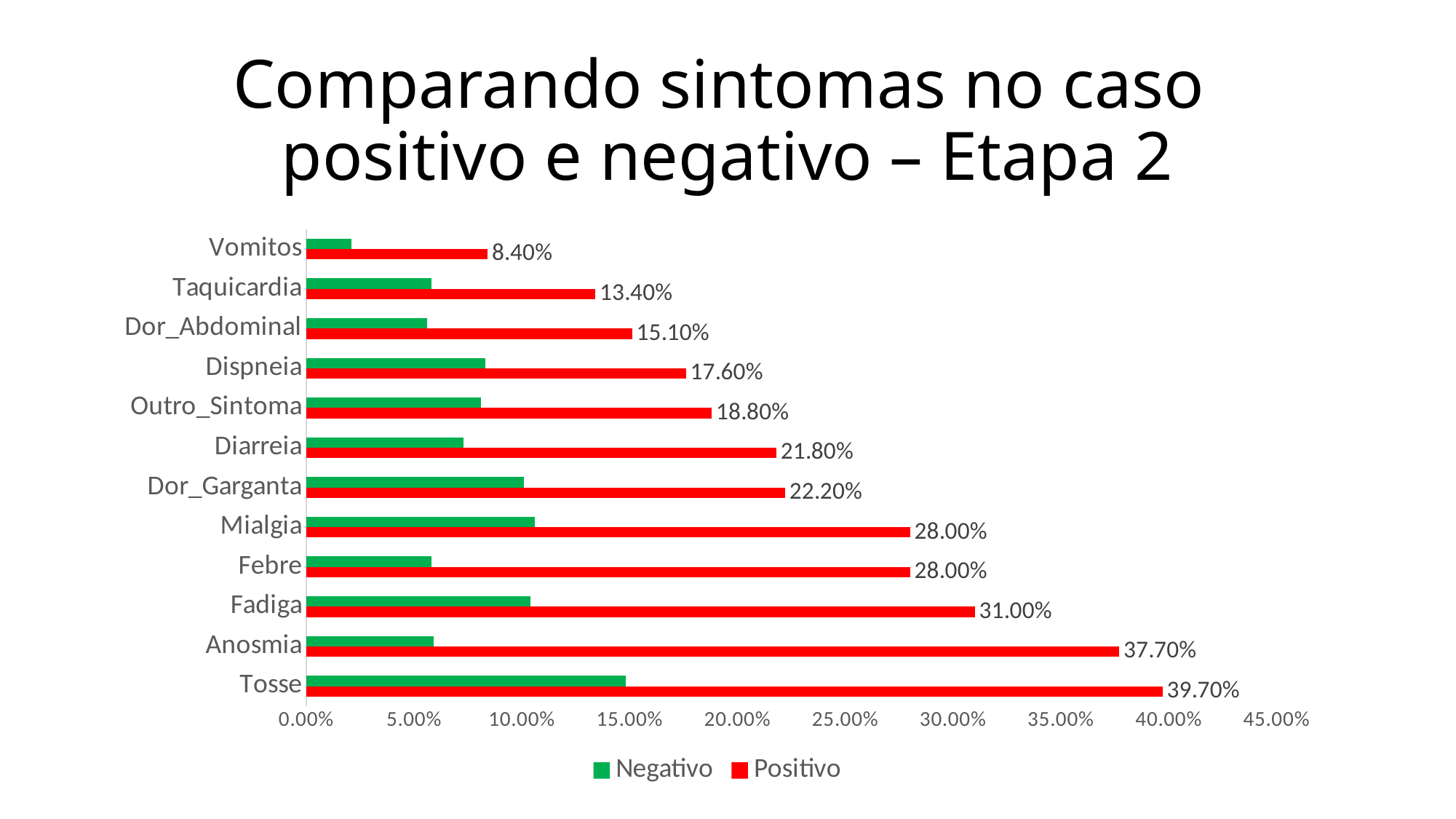
What is the Positivo value for Anosmia? 37.70% How many series does the legend list? 2 Is the Negativo value for Tosse greater or less than 10.00%? greater How many symptoms are listed on the chart? 12 What is the difference between the Positivo values for Tosse and Anosmia? 2.00% Which symptom has the highest Positivo value? Tosse Which symptom has the lowest Positivo value? Vomitos What is the Positivo value for Tosse? 39.70% What type of chart is shown on the slide? Bar chart Is the Negativo value for Vomitos greater or less than 5.00%? less Which has a larger Positivo value, Fadiga or Mialgia? Fadiga What is the Positivo value for Vomitos? 8.40%